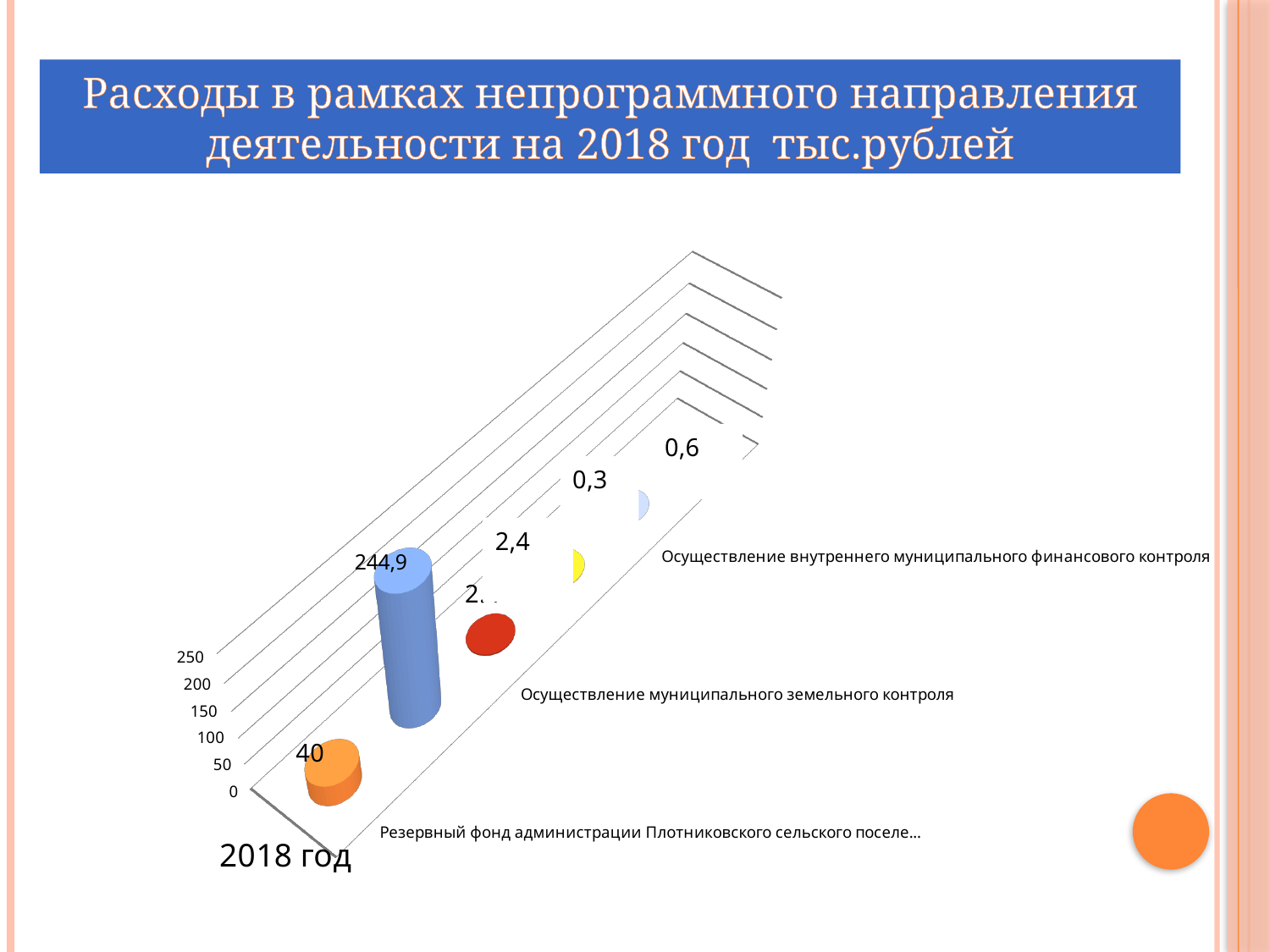
What is the highest value labelled on the chart? 244,9 What year is shown as the category on the chart's horizontal axis? 2018 год What is the difference between the values labelled 2,4 and 0,3? 2,1 Is the tallest bar's value greater or less than 200? greater What is the value for Резервный фонд администрации Плотниковского сельского поселения? 40 How many data labels are printed on the chart? 6 What is the highest tick value shown on the vertical axis? 250 Is the value for Резервный фонд greater or less than 50? less What is the lowest value labelled on the chart? 0,3 Which is larger, the value labelled 2,4 or the value labelled 0,6? 2,4 What kind of chart is shown on the slide? bar chart What is the difference between the highest labelled value (244,9) and the value for Резервный фонд (40)? 204,9